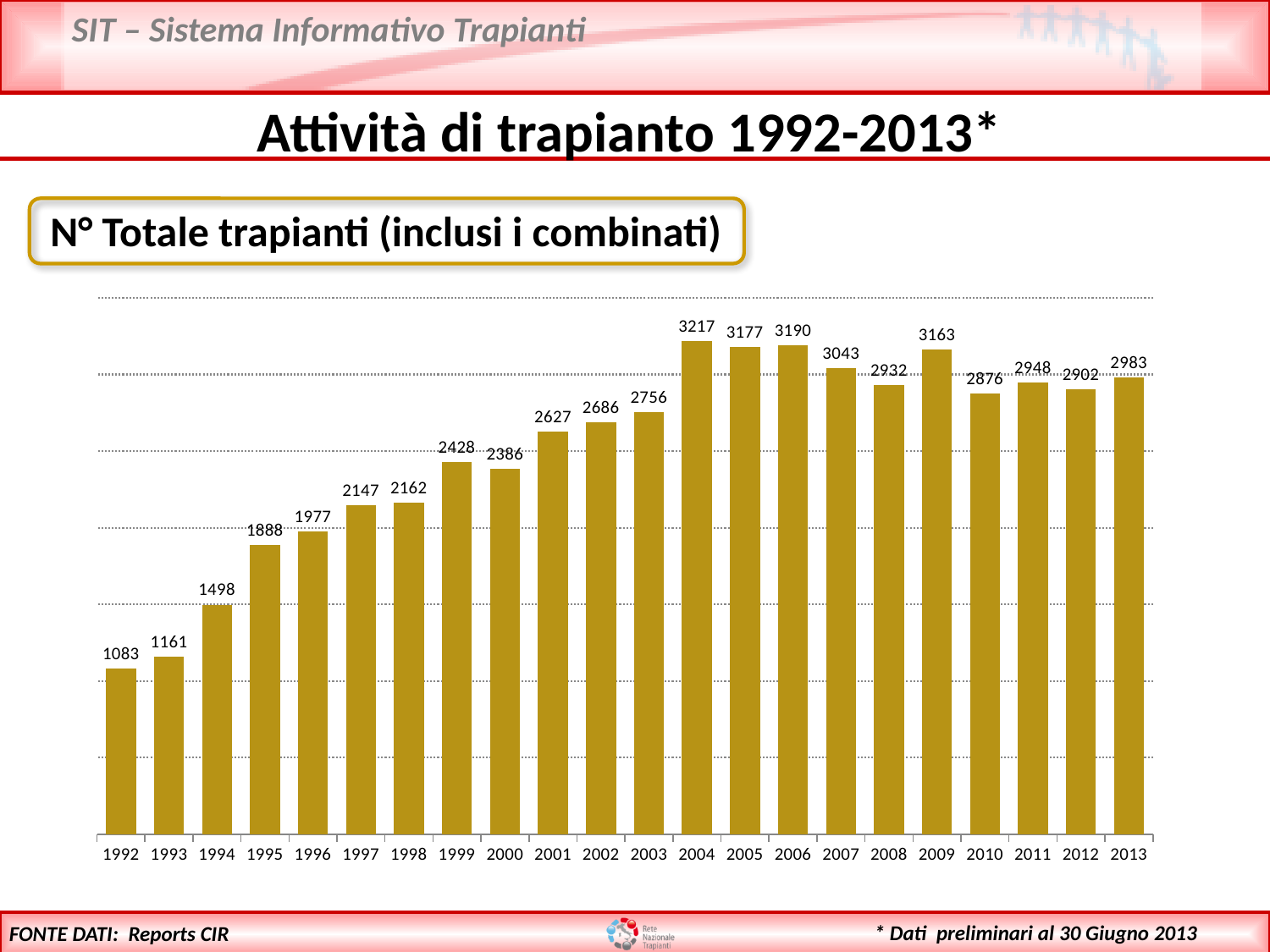
How many years are shown on the x axis? 22 Which is larger, the value for 2009 or the value for 2008? 2009 Which year has the lowest value? 1992 What is the value for 2004? 3217 What is the value for 1992? 1083 What is the value for 1999? 2428 What is the value for 2013? 2983 Which year has the highest value? 2004 What is the difference between the values for 2004 and 1992? 2134 What kind of chart is shown on the slide? bar chart Do the values generally rise or fall from 1992 to 2004? rise What is the difference between the values for 2013 and 2012? 81